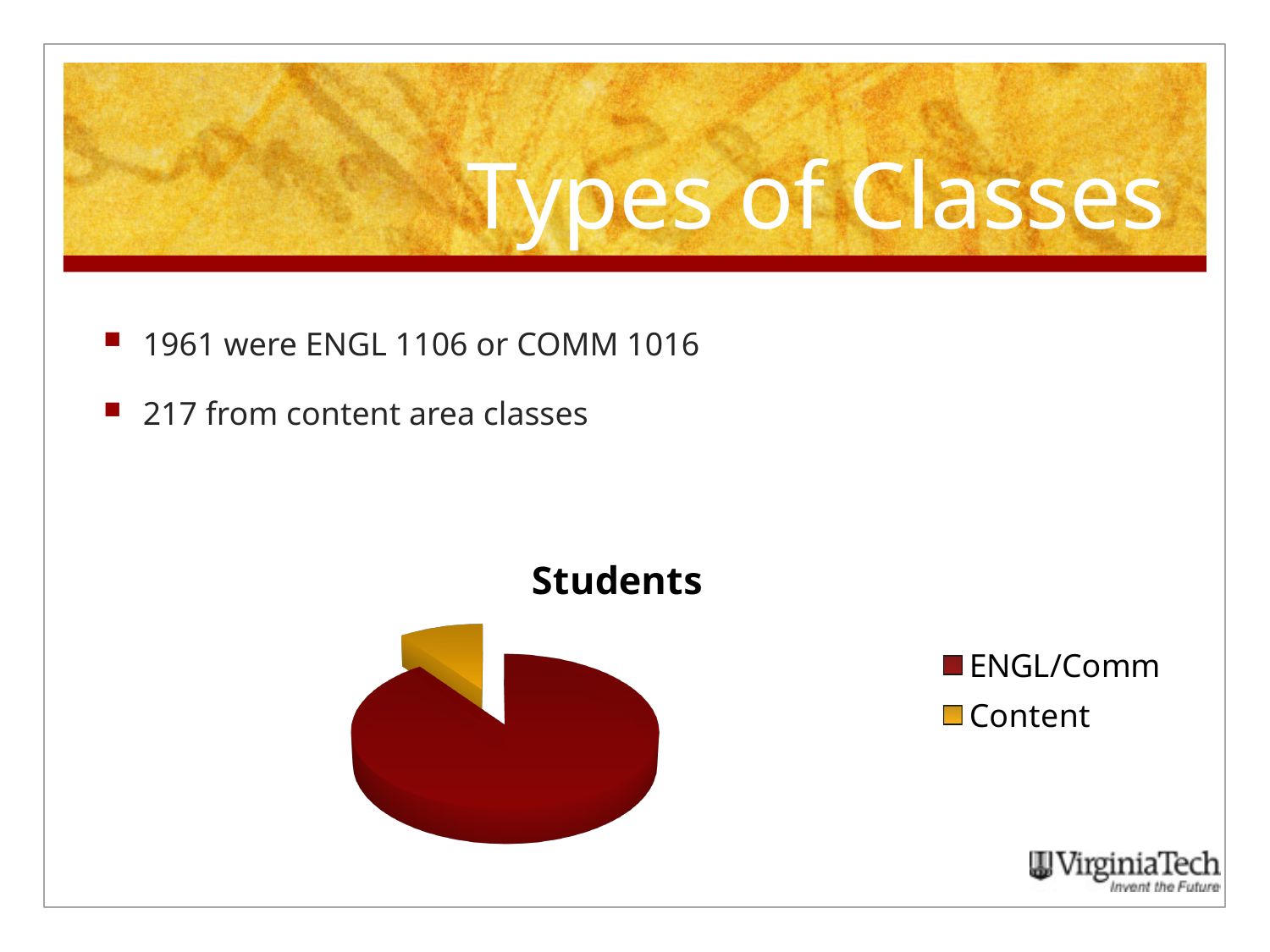
Which category has the smallest slice of the pie? Content What is the title of the chart? Students Does the ENGL/Comm slice take up more or less than half of the pie? More What colour is the Content slice in the pie chart? Gold How many slices does the pie chart have? 2 Which category has the largest slice of the pie? ENGL/Comm What kind of chart is shown on the slide? Pie chart Which slice is larger, ENGL/Comm or Content? ENGL/Comm How many entries does the chart's legend list? 2